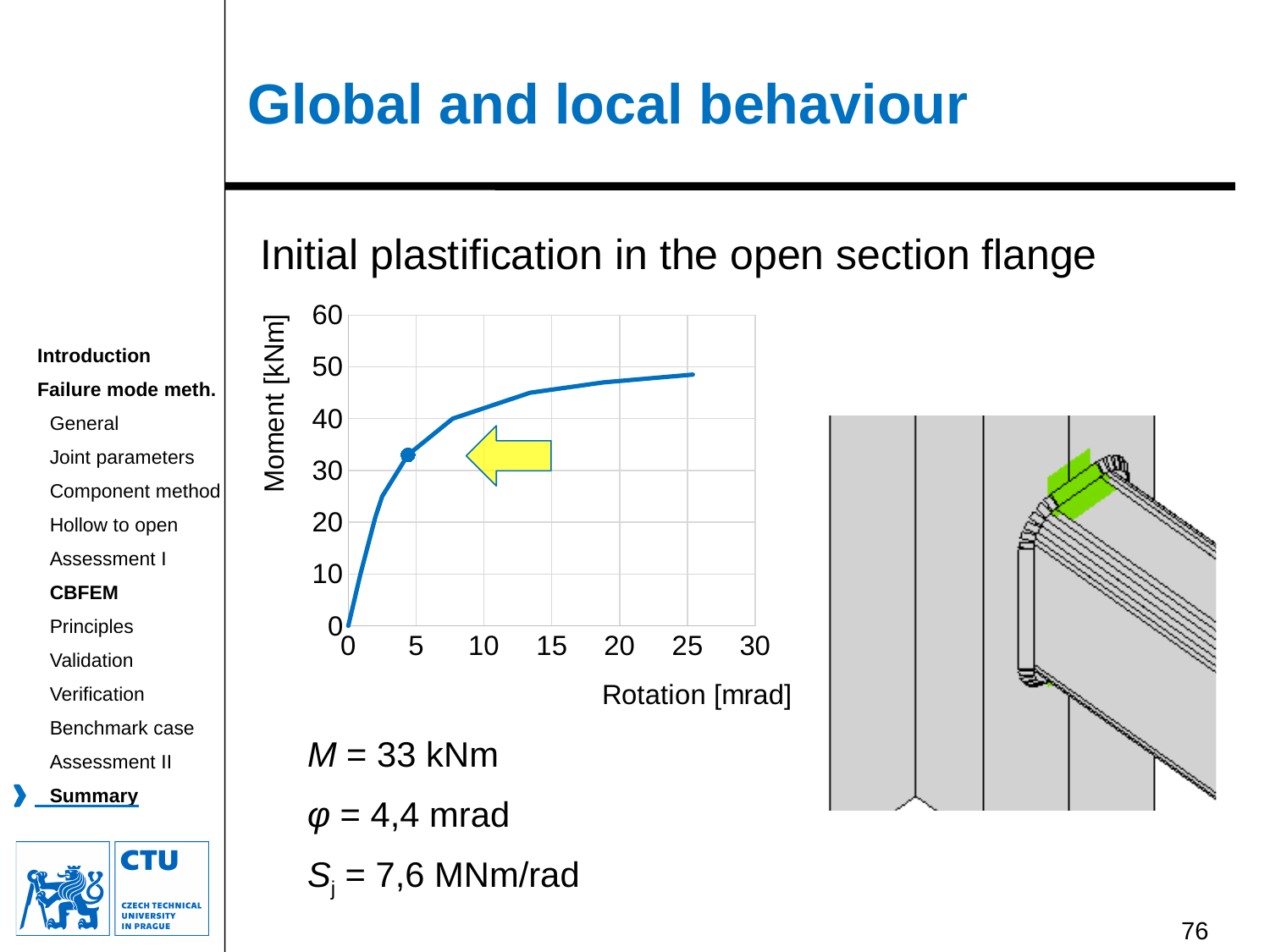
How many curves are plotted on the chart? 1 Is the highest moment reached by the curve greater or less than 50 kNm? less Is the moment at a rotation of 25 mrad greater or less than 40 kNm? greater What is the label of the horizontal axis of the chart? Rotation [mrad] What moment value corresponds to the marked point on the curve (initial plastification)? 33 kNm What is the label of the vertical axis of the chart? Moment [kNm] Does the moment rise or fall as rotation increases along the x axis? rise What is the maximum value shown on the rotation axis? 30 What kind of chart is shown on the slide? line chart Is the moment at a rotation of 10 mrad greater or less than 30 kNm? greater What rotation value corresponds to the marked point on the curve (initial plastification)? 4,4 mrad